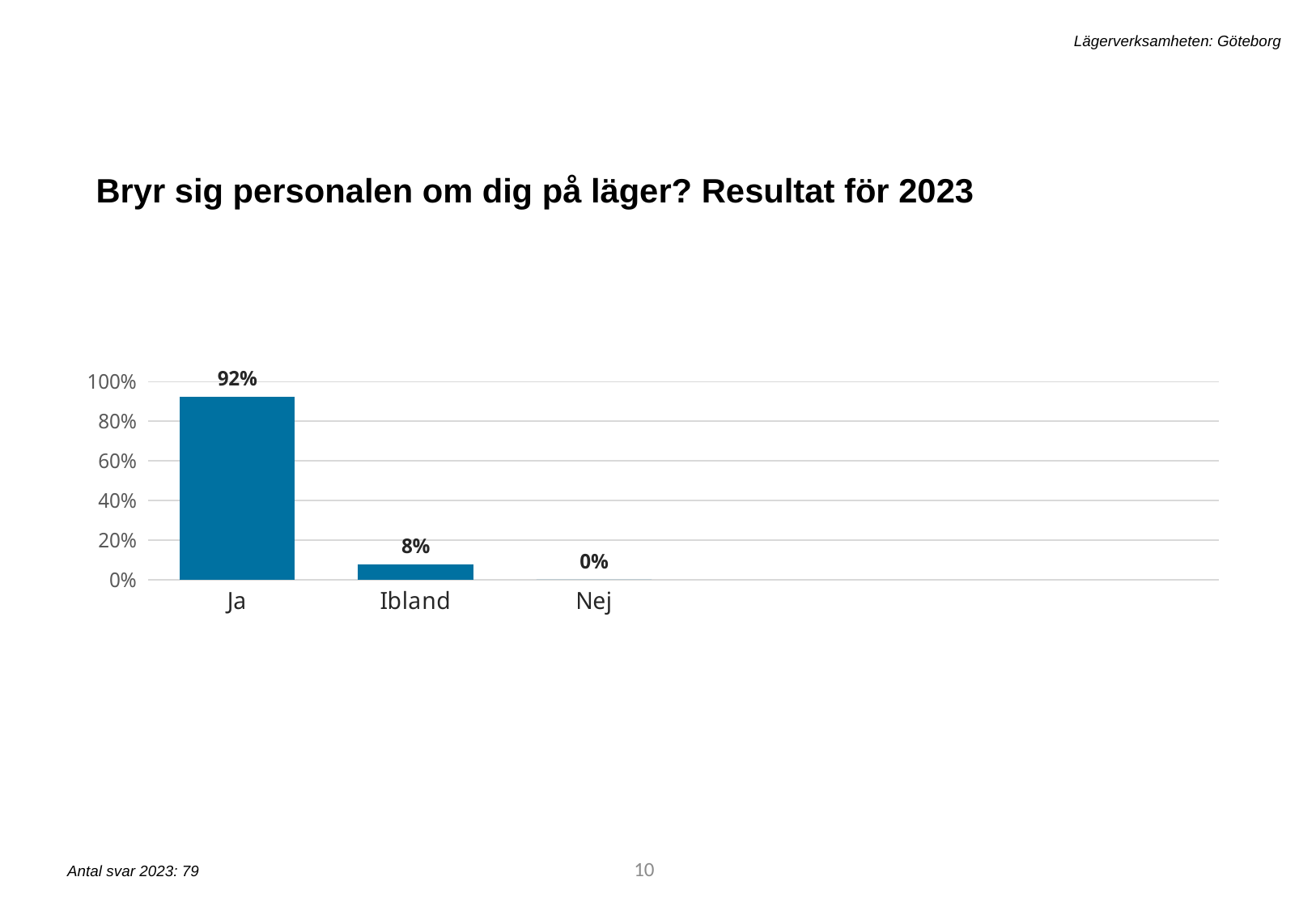
What kind of chart is shown on the slide? bar chart What is the value for Ibland? 8% Which category has the lowest value? Nej What is the difference between the values for Ja and Ibland? 84% Is the value for Ibland greater or less than 20%? less What is the title of the slide? Bryr sig personalen om dig på läger? Resultat för 2023 Which category has the highest value? Ja What is the value for Ja? 92% Which is larger, the value for Ibland or the value for Nej? Ibland What is the value for Nej? 0% Is the value for Ja greater or less than 80%? greater How many categories are shown on the x axis? 3